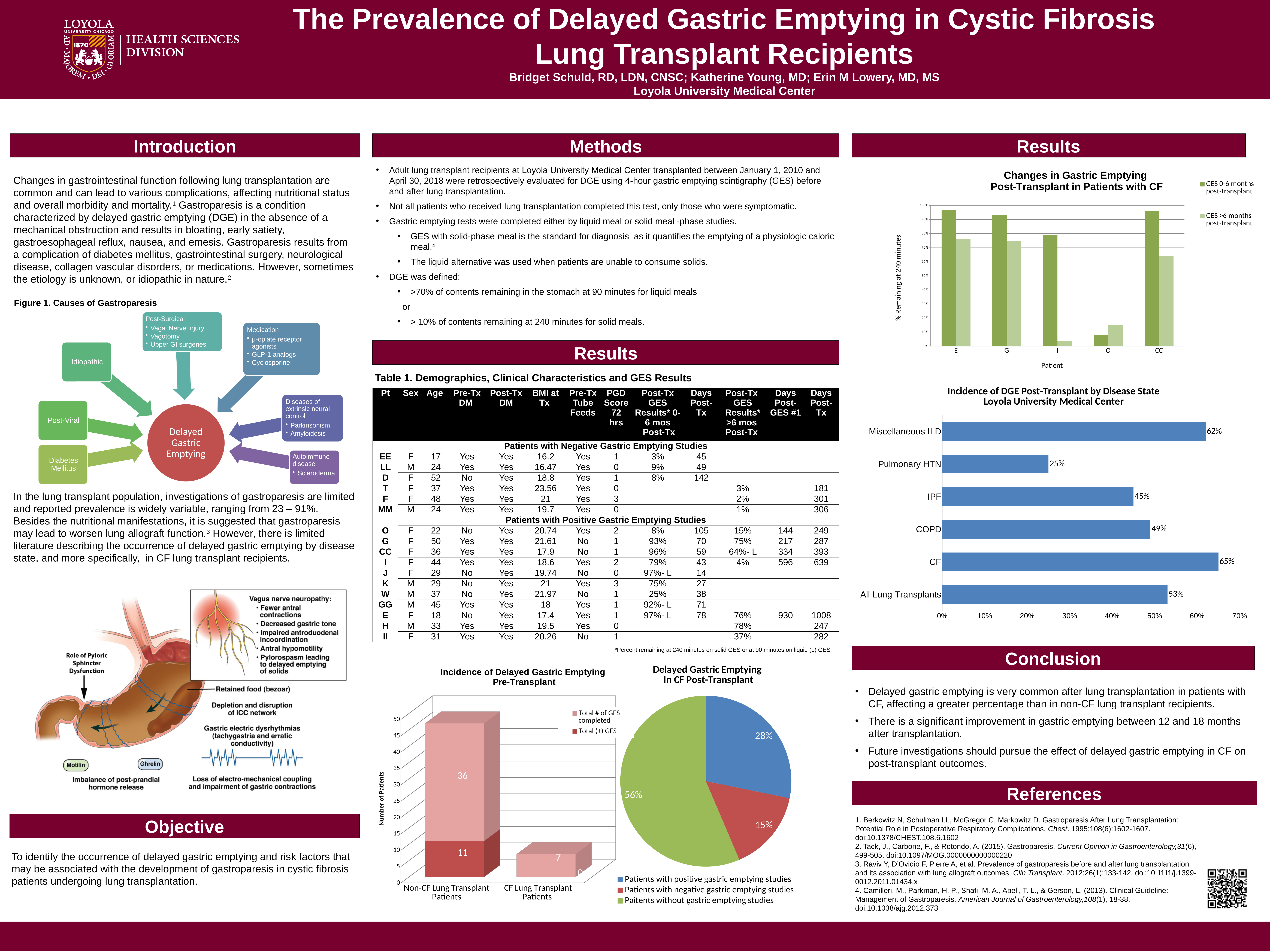
In the 'Incidence of DGE Post-Transplant by Disease State' chart, what is the difference between the values for CF and All Lung Transplants? 12% In the 'Delayed Gastric Emptying In CF Post-Transplant' pie chart, what share is for patients with positive gastric emptying studies? 28% In the 'Incidence of Delayed Gastric Emptying Pre-Transplant' chart, what is the Total # of GES completed for Non-CF Lung Transplant Patients? 36 In the 'Incidence of DGE Post-Transplant by Disease State' chart, which disease state has the highest value? CF In the 'Delayed Gastric Emptying In CF Post-Transplant' pie chart, which category has the largest slice? Paitents without gastric emptying studies In the 'Incidence of DGE Post-Transplant by Disease State' chart, which disease state has the lowest value? Pulmonary HTN In the 'Incidence of Delayed Gastric Emptying Pre-Transplant' chart, what is the Total (+) GES for Non-CF Lung Transplant Patients? 11 In the 'Changes in Gastric Emptying Post-Transplant in Patients with CF' chart, is the GES 0-6 months post-transplant value for patient O greater or less than 20%? less In the 'Incidence of DGE Post-Transplant by Disease State' chart, what is the value for CF? 65% In the 'Changes in Gastric Emptying Post-Transplant in Patients with CF' chart, how many series does the legend list? 2 In the 'Incidence of DGE Post-Transplant by Disease State' chart, how many disease-state categories are shown? 6 In the 'Incidence of DGE Post-Transplant by Disease State' chart, what is the value for Pulmonary HTN? 25%